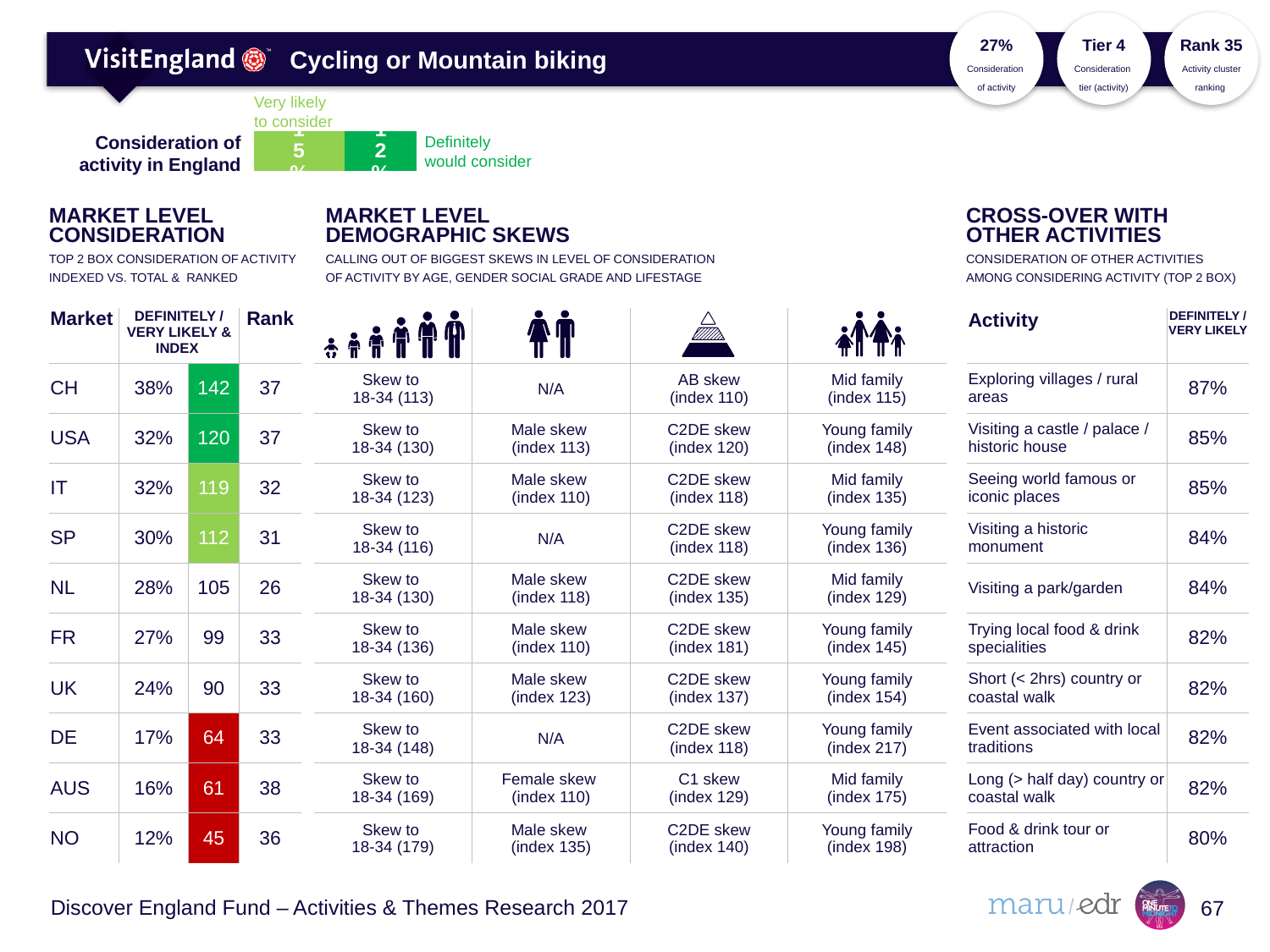
In the 'Consideration of activity in England' chart, what is the difference between 'Very likely to consider' and 'Definitely would consider'? 3% How many segments (series) does the 'Consideration of activity in England' bar chart show? 2 What kind of chart is the 'Consideration of activity in England' chart? Bar chart In the 'Consideration of activity in England' chart, what is the value for 'Very likely to consider'? 15% In the 'Consideration of activity in England' chart, which segment is shown in the darker green colour? Definitely would consider What is the total of the stacked bar in the 'Consideration of activity in England' chart? 27% In the 'Consideration of activity in England' chart, what is the value for 'Definitely would consider'? 12% In the 'Consideration of activity in England' chart, which segment is shown in the lighter green colour? Very likely to consider In the 'Consideration of activity in England' chart, which segment is larger: 'Very likely to consider' or 'Definitely would consider'? Very likely to consider